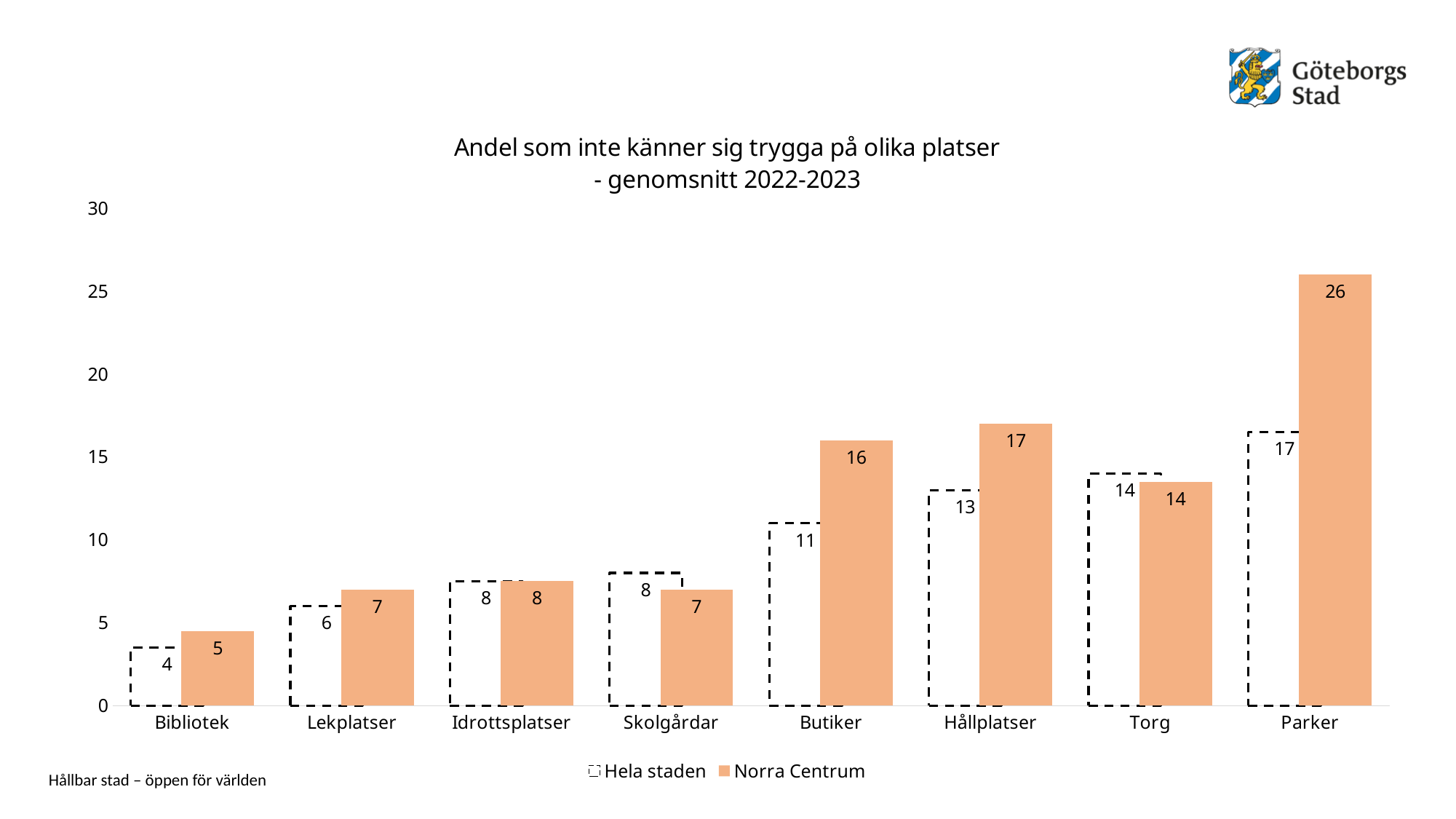
How many series does the legend list? 2 What is the difference between Norra Centrum and Hela staden at Parker? 9 Which category has the lowest value for Hela staden? Bibliotek What is the value for Norra Centrum at Parker? 26 Which category has the highest value for Norra Centrum? Parker What kind of chart is shown on the slide? Bar chart What is the value for Hela staden at Hållplatser? 13 What is the value for Norra Centrum at Butiker? 16 What is the value for Hela staden at Bibliotek? 4 Which is larger at Butiker: Hela staden or Norra Centrum? Norra Centrum How many categories are shown on the x axis? 8 Is the value for Norra Centrum at Parker greater or less than 25? greater